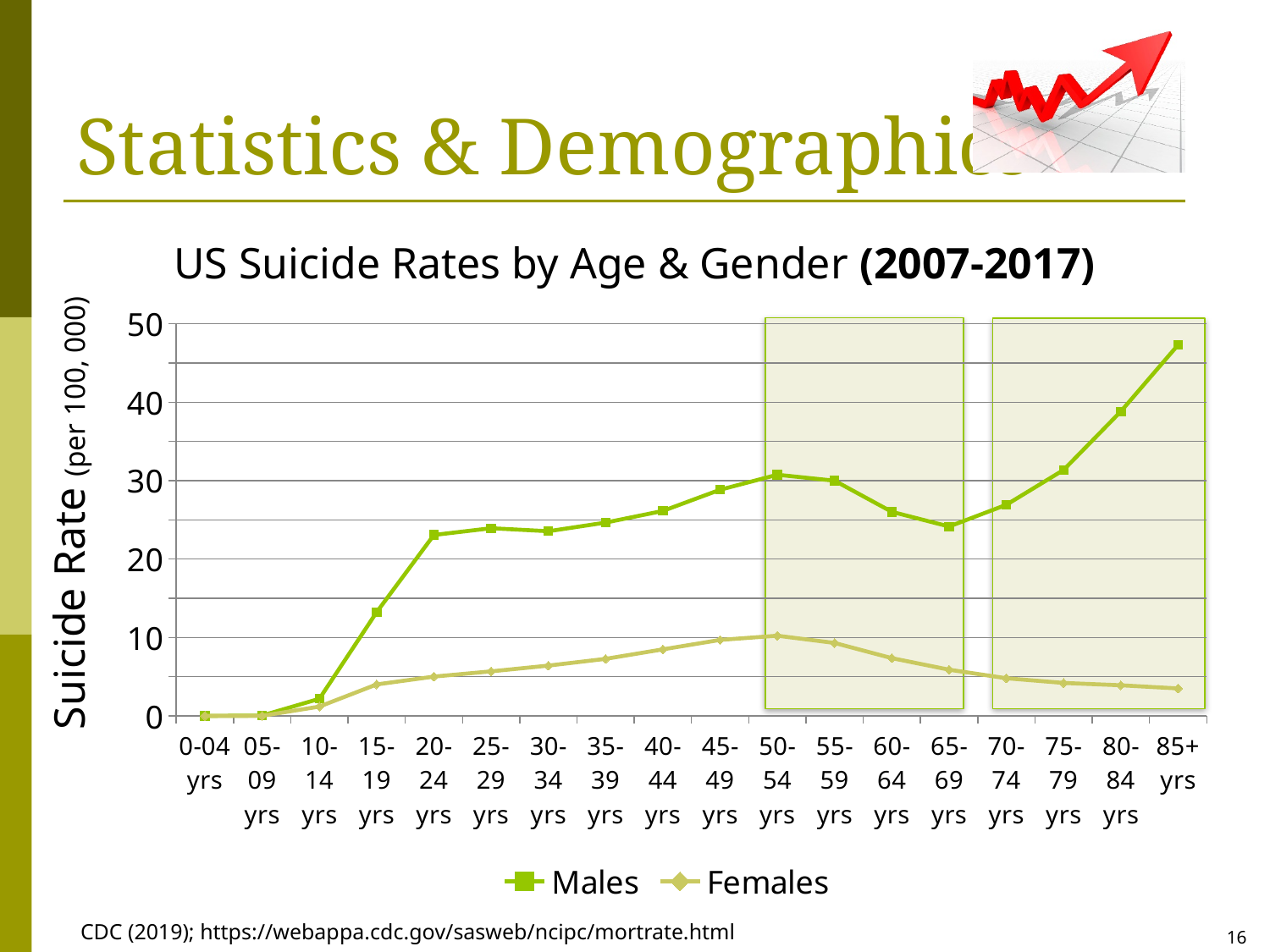
For the 85+ yrs age group, which series has the larger value, Males or Females? Males Do the Females values rise or fall from 50-54 yrs to 85+ yrs? fall Is the Males value for 85+ yrs greater or less than 40? greater Which age group has the highest suicide rate for Females? 50-54 yrs Is the Males value for 65-69 yrs greater or less than 30? less Which age group has the highest suicide rate for Males? 85+ yrs Is the Males value for 15-19 yrs greater or less than 10? greater What is the title of the chart? US Suicide Rates by Age & Gender (2007-2017) How many age groups are plotted along the x axis? 18 What kind of chart is shown on the slide? Line chart How many series does the legend list? 2